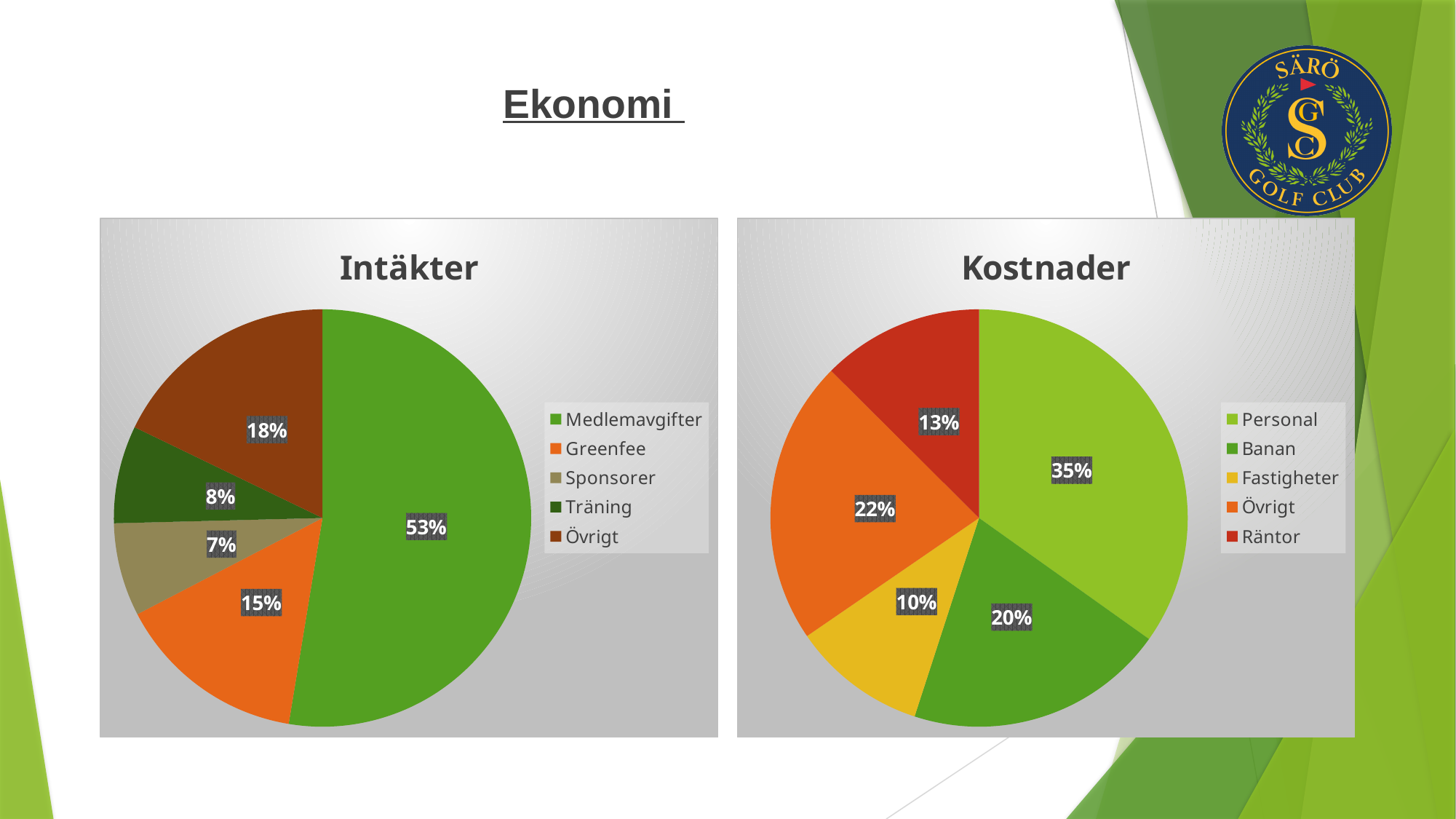
In the Kostnader chart, which category has the smallest share? Fastigheter In the Intäkter chart, which category has the smallest share? Sponsorer In the Kostnader chart, what share does Räntor have? 13% In the Kostnader chart, which category has the largest share? Personal What type of chart is the Kostnader chart? Pie chart What is the title of the chart on the left of the slide? Intäkter In the Intäkter chart, what is the difference between the shares of Övrigt and Träning? 10% In the Intäkter chart, how many categories does the legend list? 5 In the Kostnader chart, which is larger, Övrigt or Banan? Övrigt In the Intäkter chart, what share does Greenfee have? 15% In the Intäkter chart, what share does Medlemavgifter have? 53% In the Kostnader chart, what share does Personal have? 35%